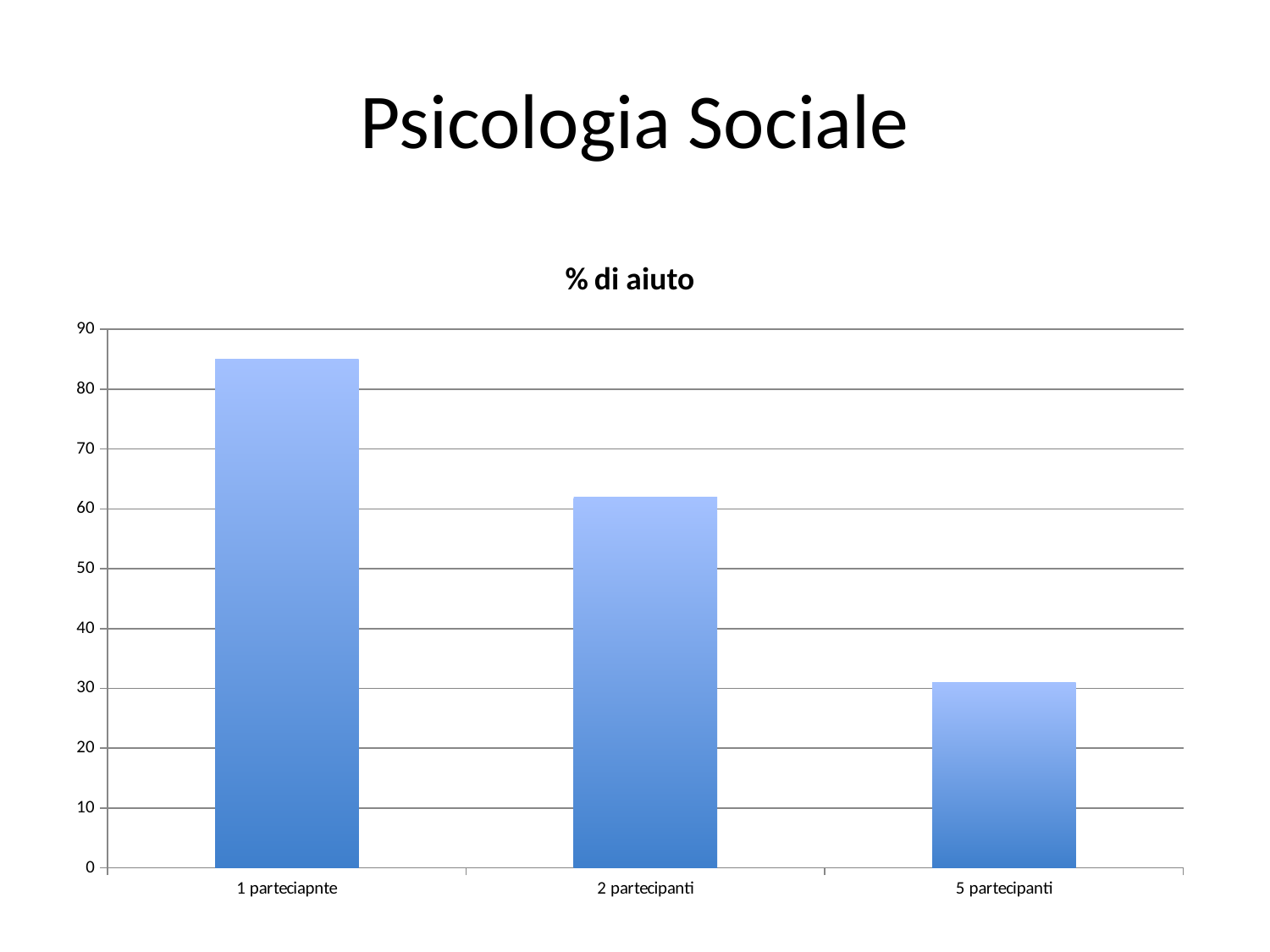
How many categories are shown on the x axis of the chart? 3 Do the values rise or fall from left to right along the x axis? fall Which is larger, the value for 2 partecipanti or the value for 5 partecipanti? 2 partecipanti What is the highest value shown on the y axis of the chart? 90 Which is larger, the value for 1 parteciapnte or the value for 2 partecipanti? 1 parteciapnte Is the value for 2 partecipanti greater or less than 70? less What kind of chart is shown on the slide? bar chart Which category has the highest value in the chart? 1 parteciapnte Which category has the lowest value in the chart? 5 partecipanti Is the value for 5 partecipanti greater or less than 40? less What is the title of the chart? % di aiuto Is the value for 1 parteciapnte greater or less than 80? greater